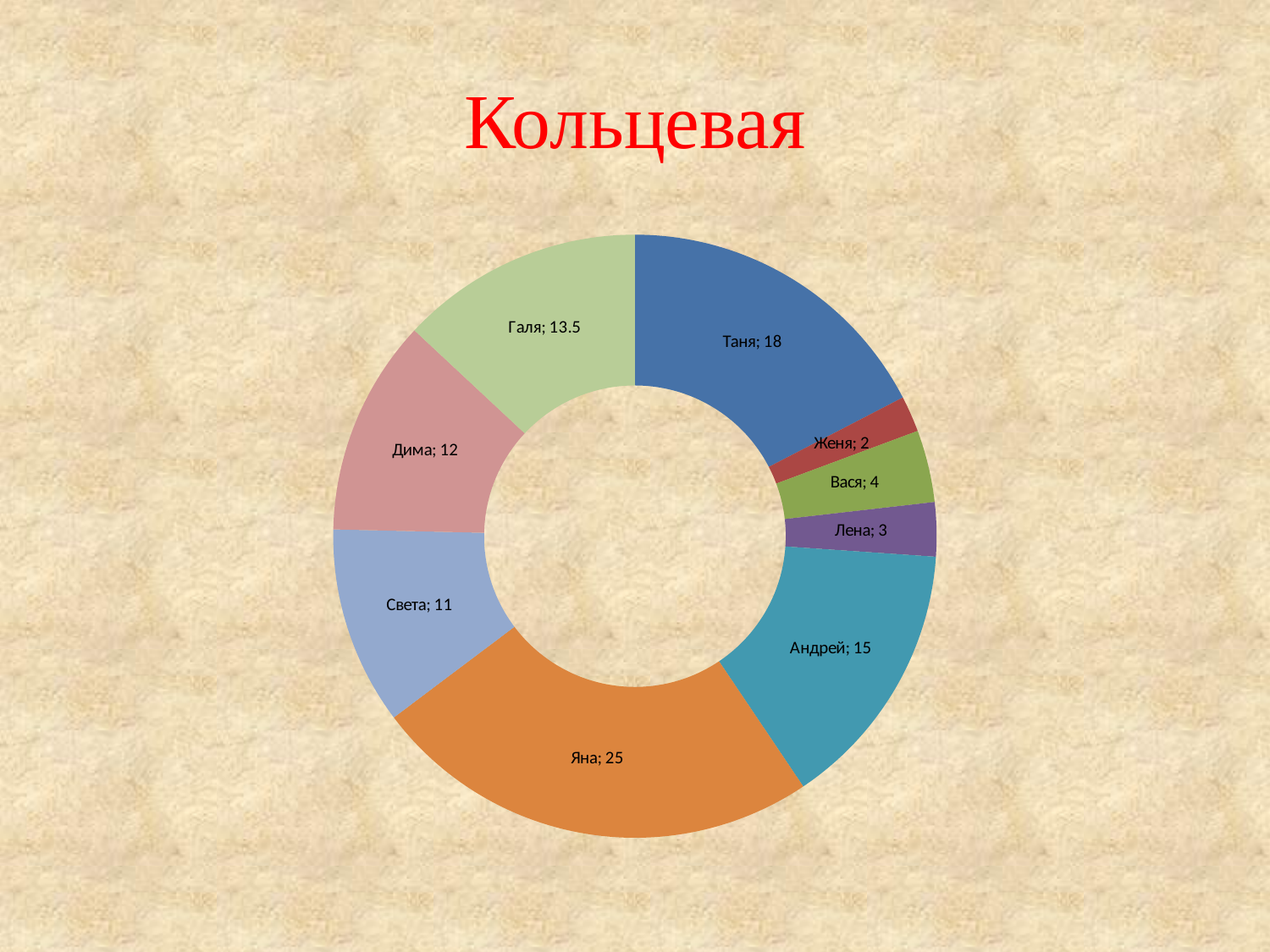
What is the difference between the values for Дима and Света? 1 What is the value for Галя? 13.5 What kind of chart is shown on the slide? doughnut chart How many categories are shown in the chart? 9 What is the title of the slide? Кольцевая Which is larger, the value for Вася or the value for Лена? Вася What is the total of all the values in the chart? 103.5 What is the value for Андрей? 15 What is the value for Таня? 18 Which category has the smallest value? Женя What is the difference between the values for Яна and Таня? 7 Which category has the largest value? Яна